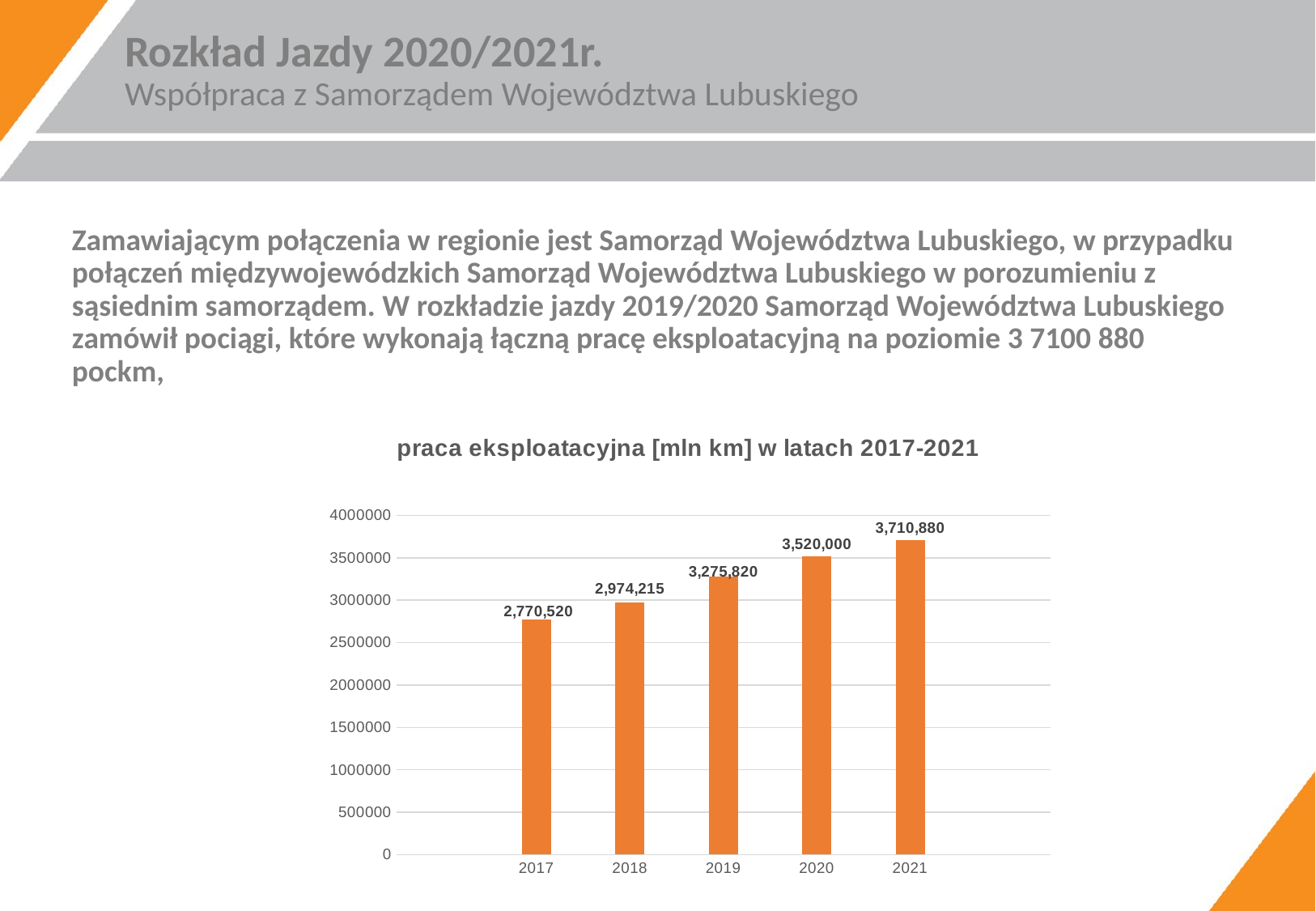
Which year has the highest value? 2021 What is the value for 2019? 3,275,820 Which year has the lowest value? 2017 Is the value for 2019 greater or less than 3000000? greater What is the difference between the values for 2021 and 2020? 190,880 What is the value for 2021? 3,710,880 What is the value for 2017? 2,770,520 Which is larger, the value for 2018 or the value for 2020? 2020 What is the difference between the values for 2018 and 2017? 203,695 How many years are shown on the x axis? 5 What kind of chart is shown on the slide? bar chart Do the values rise or fall from 2017 to 2021? rise